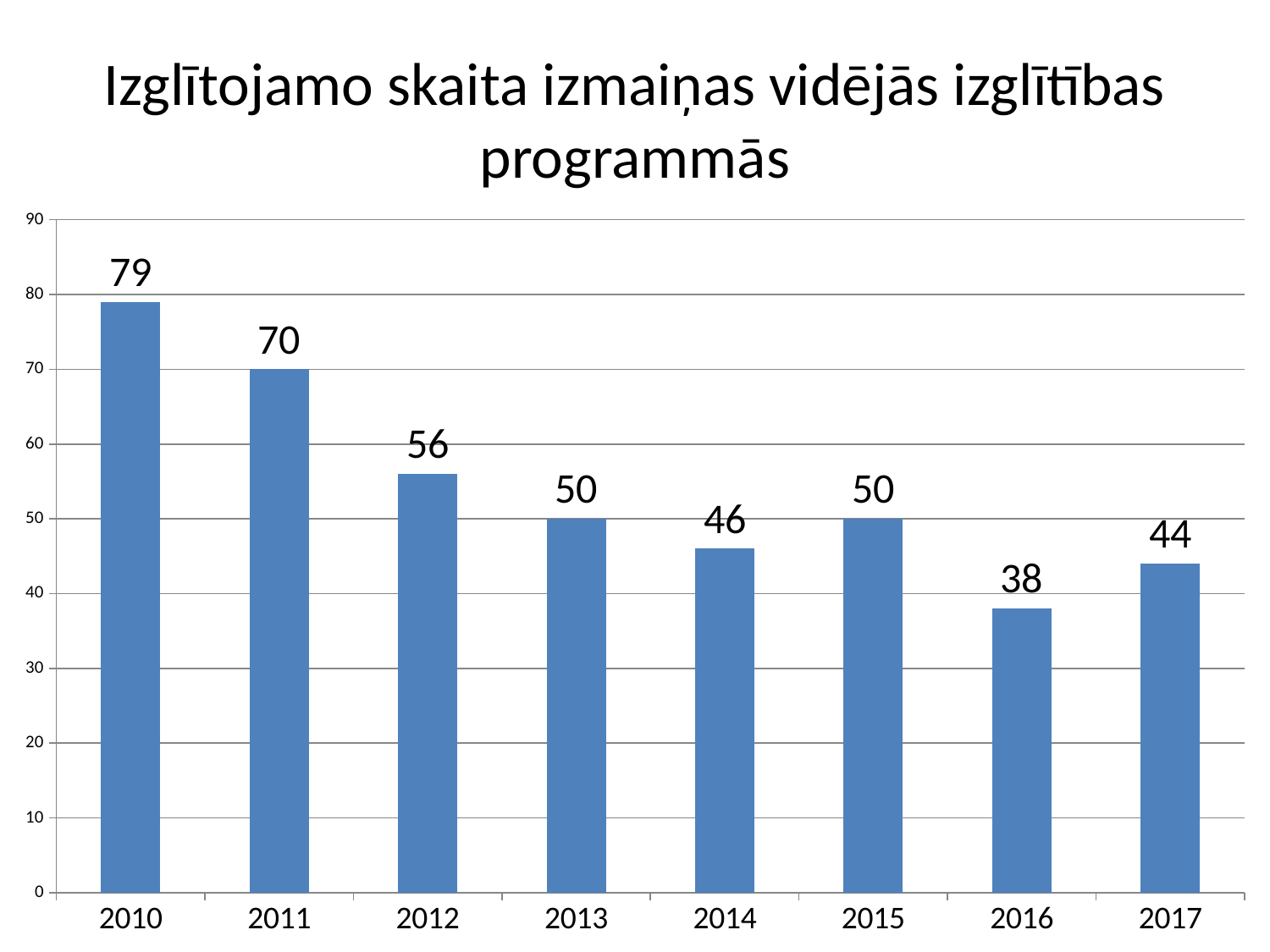
Which year has the highest value? 2010 What is the difference between the values for 2010 and 2017? 35 What kind of chart is this? bar chart What is the value for 2014? 46 What is the difference between the values for 2011 and 2012? 14 How many years are shown on the x axis? 8 Do the values generally rise or fall from 2010 to 2016? fall What is the value for 2010? 79 Is the value for 2012 greater or less than 50? greater Which year has the lowest value? 2016 Which is larger, the value for 2015 or the value for 2016? 2015 What is the value for 2016? 38